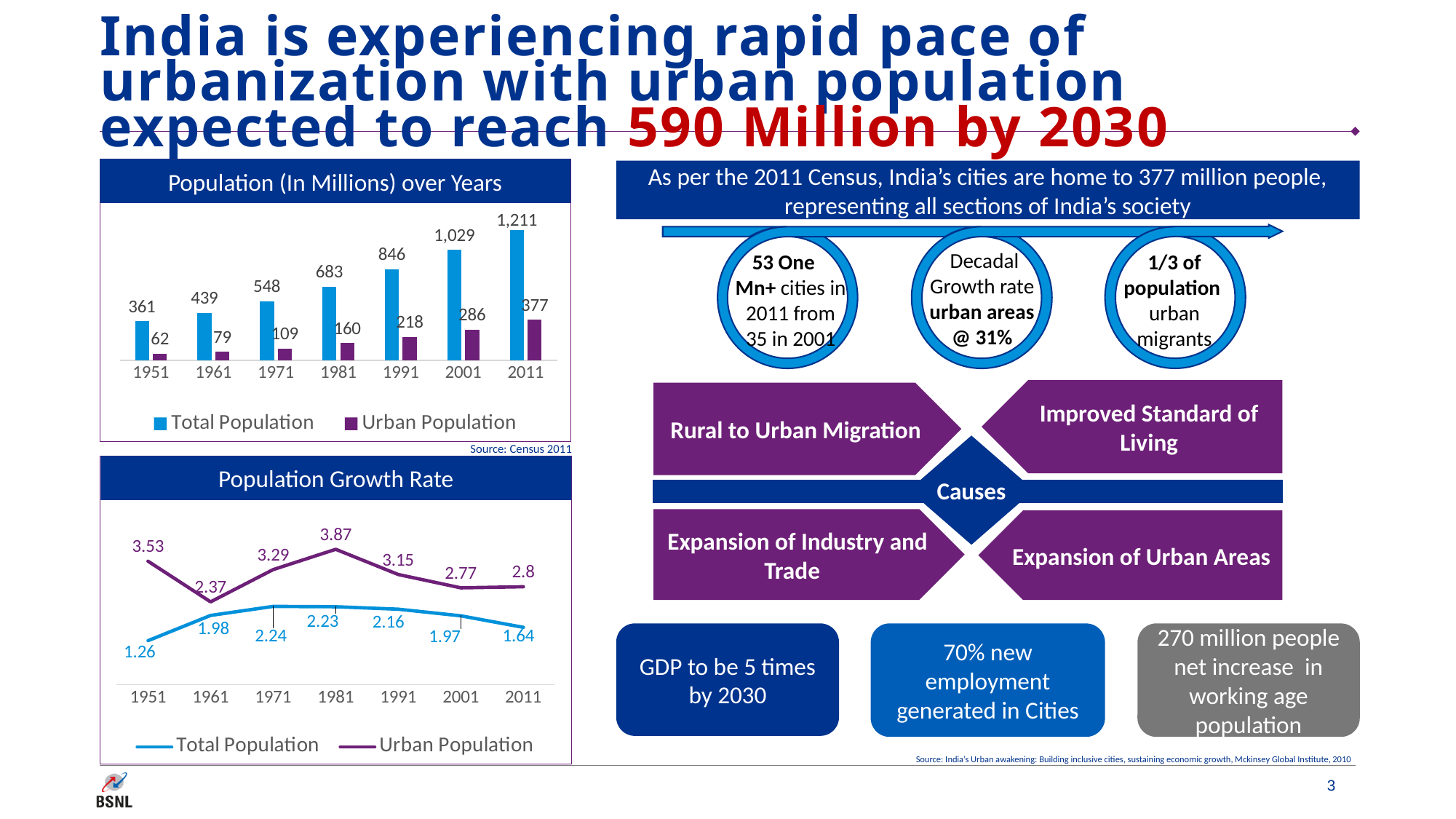
In the 'Population (In Millions) over Years' chart, how many years are shown on the x axis? 7 In the 'Population (In Millions) over Years' chart, which year has the lowest Urban Population? 1951 In the 'Population Growth Rate' chart, which year has the highest Total Population growth rate? 1971 How many series does the legend of the 'Population Growth Rate' chart list? 2 In the 'Population (In Millions) over Years' chart, what is the Urban Population value for 1991? 218 In the 'Population Growth Rate' chart, what is the Urban Population growth rate for 1981? 3.87 In the 'Population (In Millions) over Years' chart, what is the difference between Total Population and Urban Population in 2001? 743 In the 'Population Growth Rate' chart, which is larger in 1961: the Total Population growth rate or the Urban Population growth rate? Urban Population In the 'Population (In Millions) over Years' chart, does the Total Population rise or fall from 1951 to 2011? Rise What kind of chart is 'Population (In Millions) over Years'? Bar chart In the 'Population (In Millions) over Years' chart, what is the Total Population value for 2011? 1,211 In the 'Population Growth Rate' chart, what is the difference between the Urban Population and Total Population growth rates in 2011? 1.16